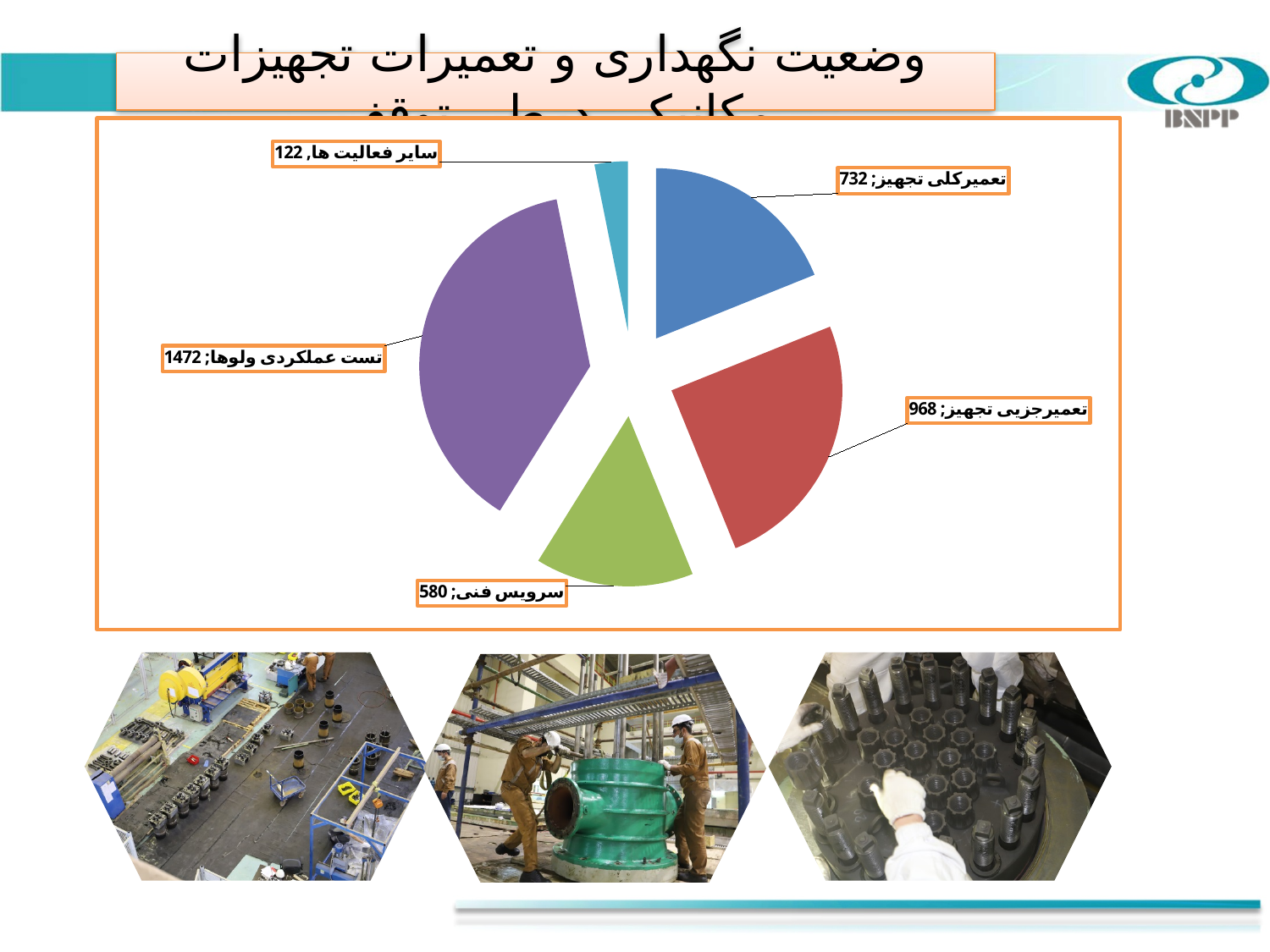
What is the value for تعمیرجزیی تجهیز? 968 What is the value for سرویس فنی? 580 What is the value for سایر فعالیت ها? 122 What colour is the slice for تست عملکردی ولوها? purple What is the value for تست عملکردی ولوها? 1472 Which is larger, the value for تعمیرکلی تجهیز or the value for سرویس فنی? تعمیرکلی تجهیز How many slices does the pie chart have? 5 Which category has the largest slice of the pie? تست عملکردی ولوها Which category has the smallest slice of the pie? سایر فعالیت ها What type of chart is shown on the slide? pie chart What is the total of all the values shown in the pie chart? 3874 What is the difference between the values for تعمیرجزیی تجهیز and تعمیرکلی تجهیز? 236